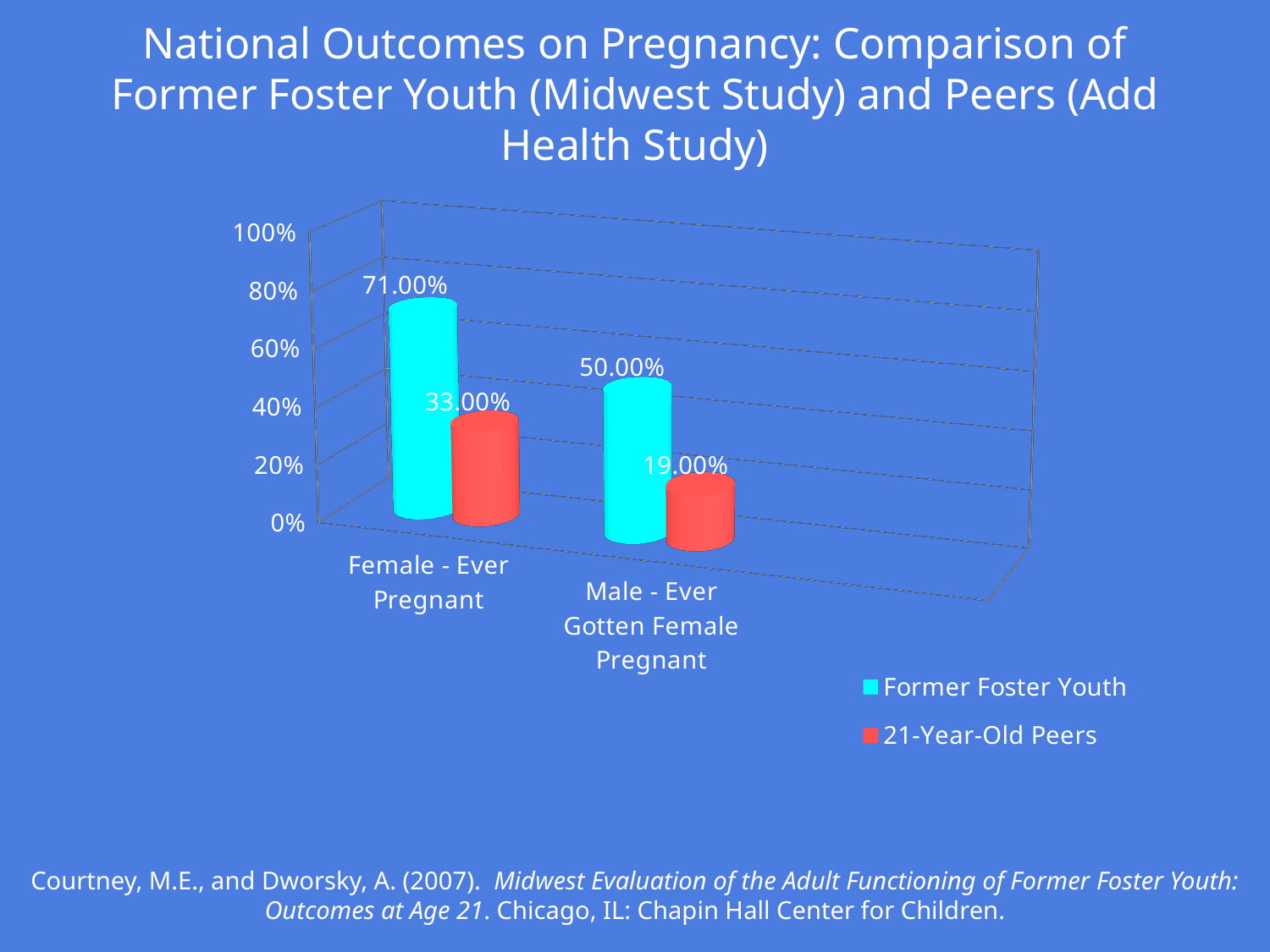
Which category has the highest value for Former Foster Youth? Female - Ever Pregnant What is the difference between Former Foster Youth and 21-Year-Old Peers in the Female - Ever Pregnant category? 38.00% What is the difference between Former Foster Youth and 21-Year-Old Peers in the Male - Ever Gotten Female Pregnant category? 31.00% Which is larger in the Male - Ever Gotten Female Pregnant category: Former Foster Youth or 21-Year-Old Peers? Former Foster Youth What is the value for Former Foster Youth in the Female - Ever Pregnant category? 71.00% Which category has the lowest value for 21-Year-Old Peers? Male - Ever Gotten Female Pregnant What kind of chart is shown on the slide? Bar chart How many series does the legend list? 2 What is the value for 21-Year-Old Peers in the Male - Ever Gotten Female Pregnant category? 19.00% What is the value for 21-Year-Old Peers in the Female - Ever Pregnant category? 33.00% What is the value for Former Foster Youth in the Male - Ever Gotten Female Pregnant category? 50.00% How many categories are shown on the x axis? 2